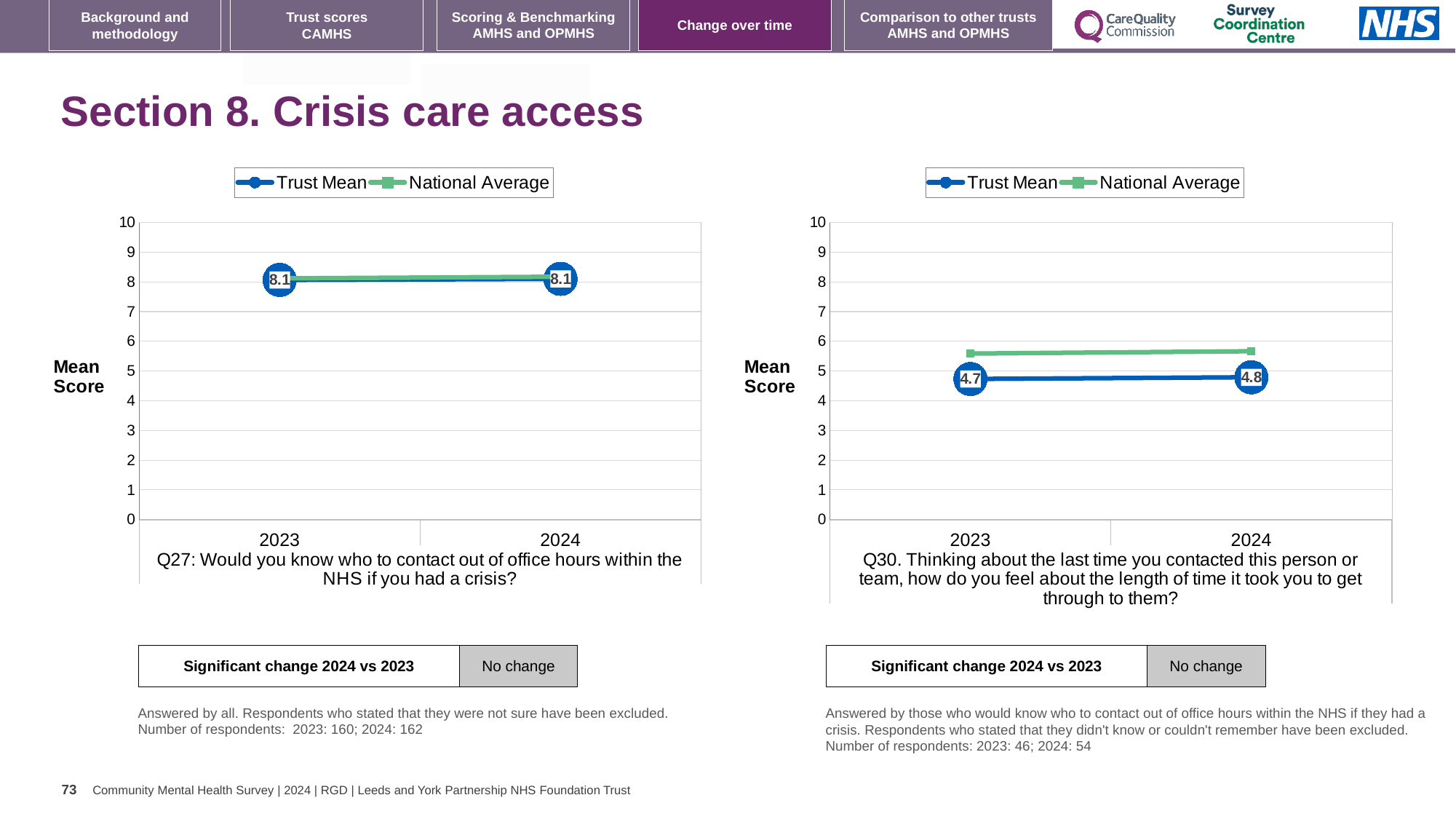
In the right chart (Q30), is the National Average value for 2024 greater or less than 5? greater What kind of chart is the left chart (Q27)? line chart What is the y-axis label of the left chart (Q27)? Mean Score In the right chart (Q30), does the Trust Mean rise or fall from 2023 to 2024? rise In the left chart (Q27), what is the Trust Mean score for 2023? 8.1 How many series does the legend of the right chart (Q30) list? 2 How many years are shown on the x axis of the left chart (Q27)? 2 In the right chart (Q30), what is the Trust Mean score for 2024? 4.8 In the left chart (Q27), what is the Trust Mean score for 2024? 8.1 In the right chart (Q30), which series has the higher value in 2023, Trust Mean or National Average? National Average In the right chart (Q30), what is the Trust Mean score for 2023? 4.7 In the right chart (Q30), what is the difference between the Trust Mean scores for 2024 and 2023? 0.1